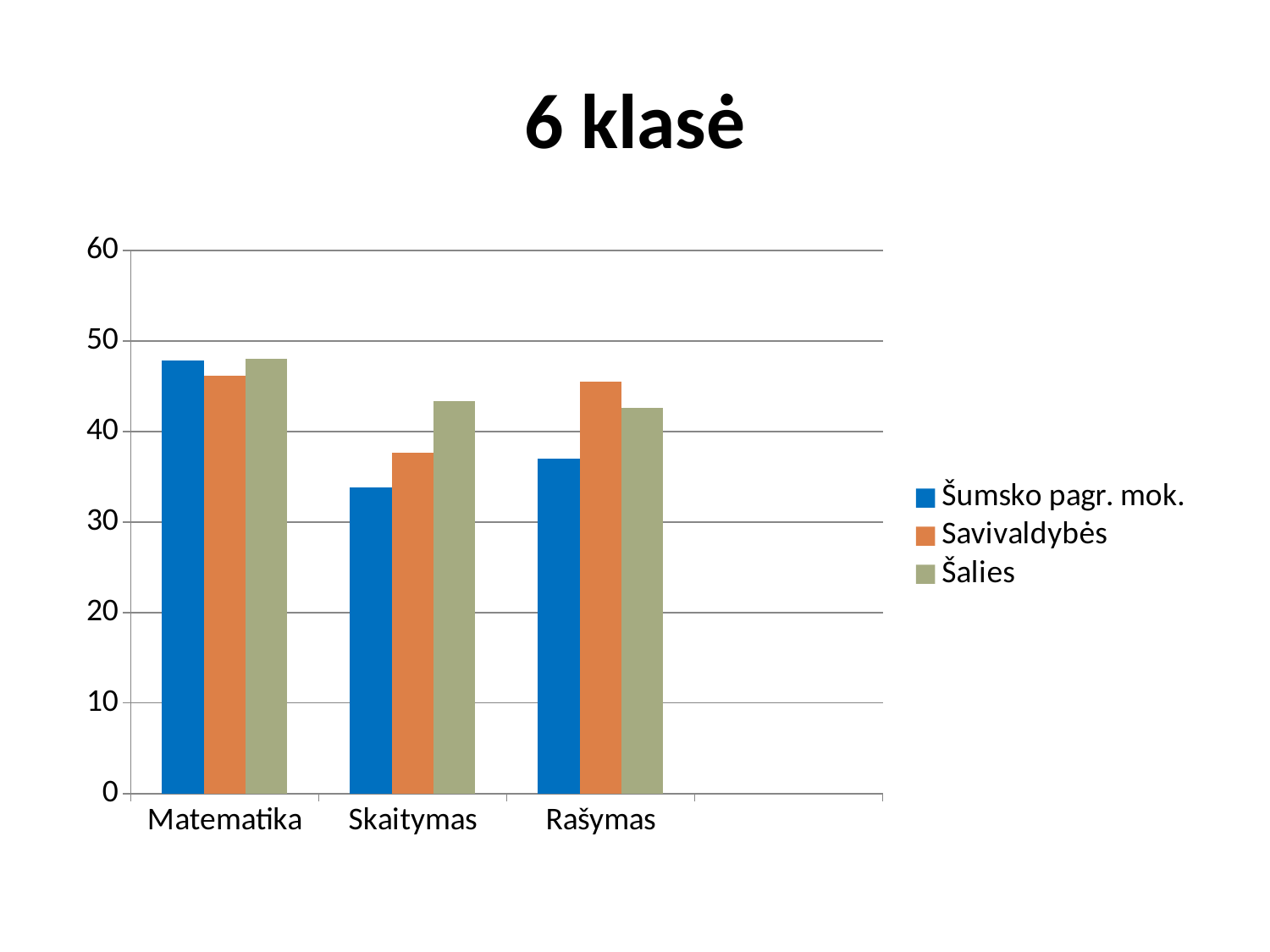
For Skaitymas, which is larger: Šumsko pagr. mok. or Šalies? Šalies In which category is the Savivaldybės value lowest? Skaitymas Is the Šumsko pagr. mok. value for Skaitymas greater or less than 40? less For Rašymas, which is larger: Šumsko pagr. mok. or Savivaldybės? Savivaldybės What kind of chart is shown on the slide? bar chart In which category is the Šumsko pagr. mok. value highest? Matematika Which series is shown in orange in the legend? Savivaldybės How many series does the legend list? 3 Is the Savivaldybės value for Rašymas greater or less than 40? greater What is the title of the slide? 6 klasė How many categories are shown on the x axis? 3 In which category is the Šumsko pagr. mok. value lowest? Skaitymas